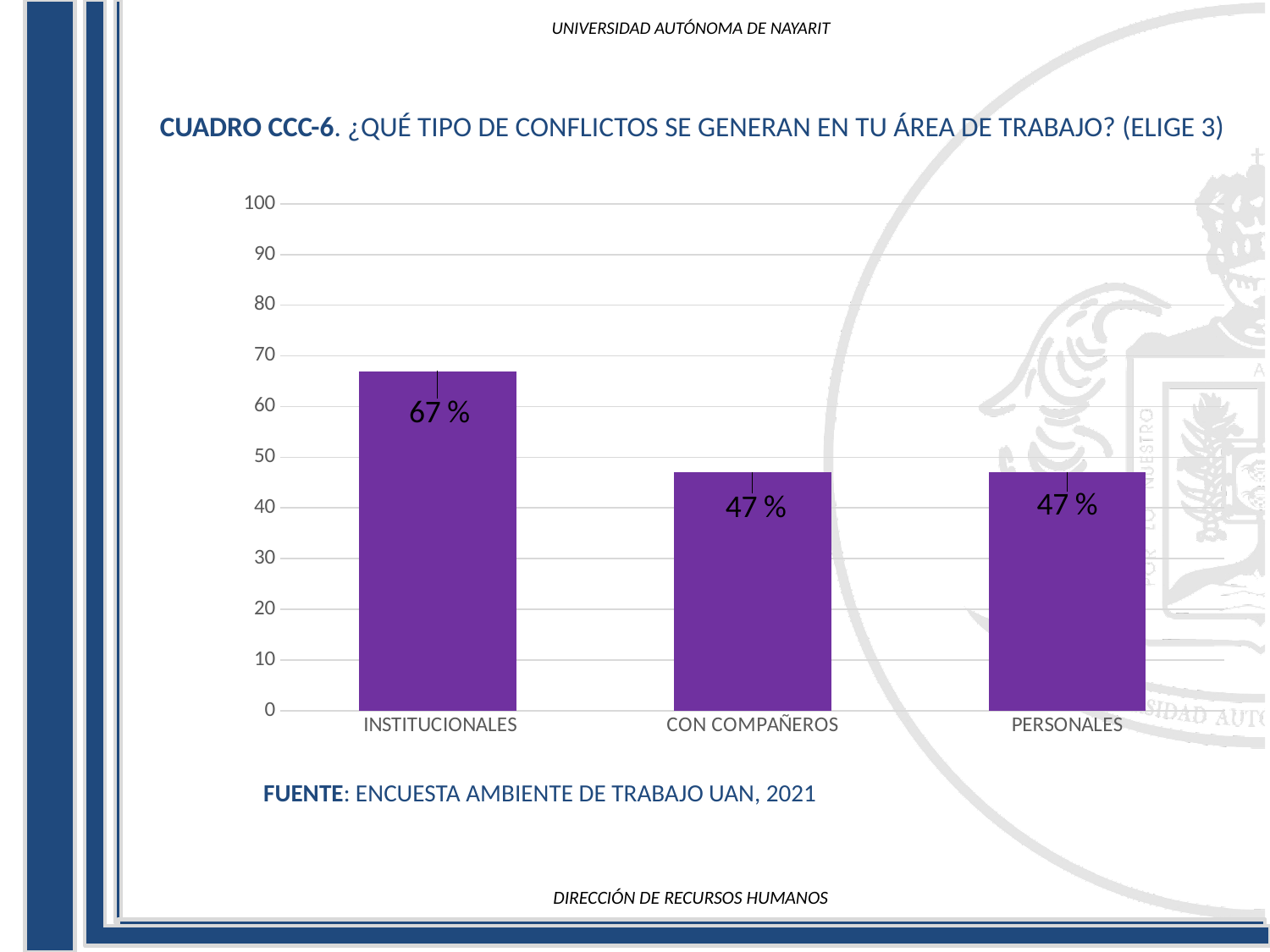
What kind of chart is shown on the slide? bar chart Which is larger, the value for INSTITUCIONALES or the value for PERSONALES? INSTITUCIONALES Which category has the highest value? INSTITUCIONALES What is the value for CON COMPAÑEROS? 47 % How many categories are shown on the x axis? 3 What is the maximum value shown on the y axis? 100 What is the source cited below the chart? ENCUESTA AMBIENTE DE TRABAJO UAN, 2021 What is the value for PERSONALES? 47 % Is the value for INSTITUCIONALES greater or less than 60? greater Is the value for PERSONALES greater or less than 50? less What is the value for INSTITUCIONALES? 67 % What is the difference between the values for INSTITUCIONALES and CON COMPAÑEROS? 20 %